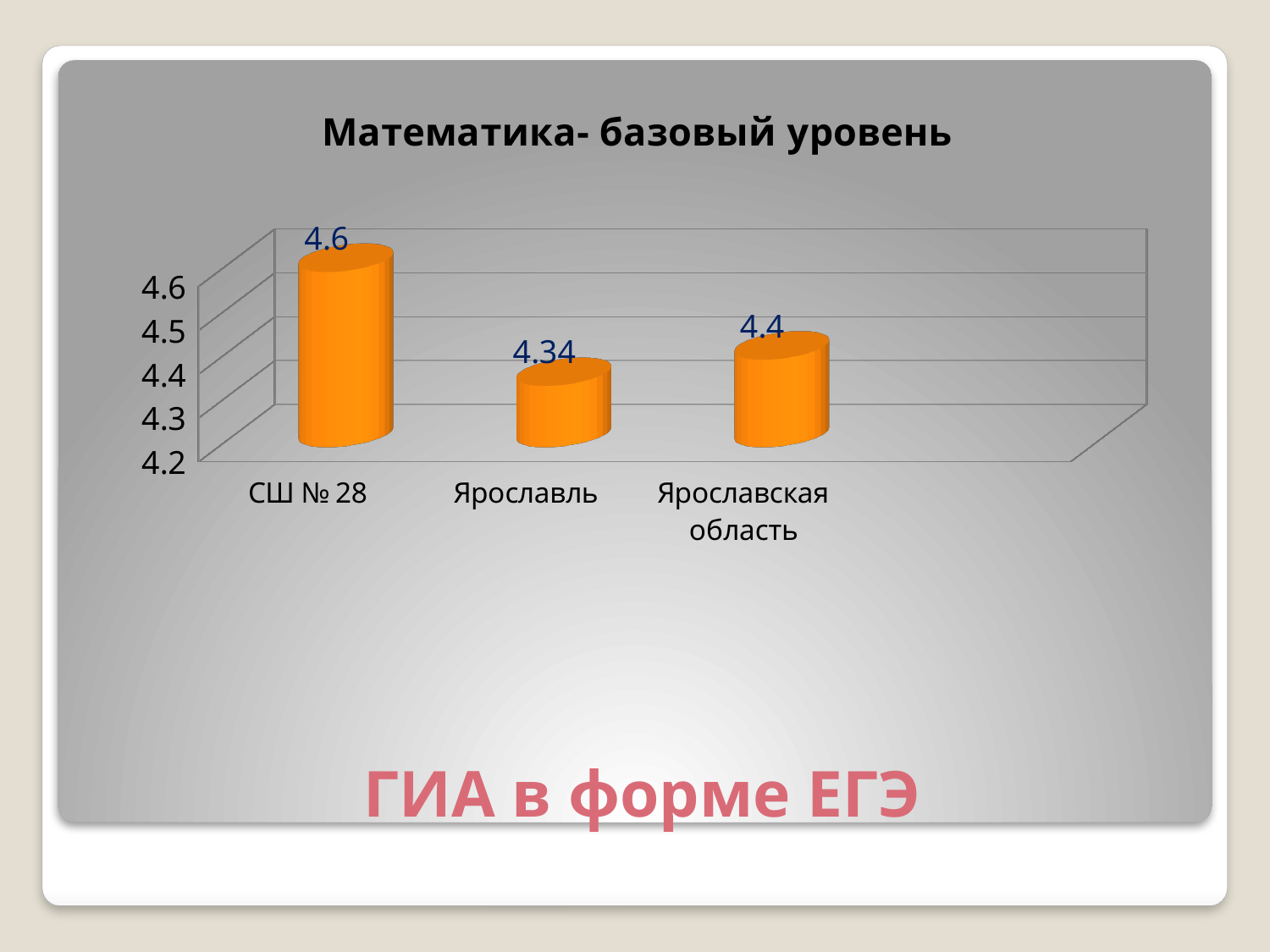
Which is larger, the value for СШ № 28 or the value for Ярославская область? СШ № 28 How many categories are shown in the chart? 3 Is the value for Ярославль greater or less than 4.5? less What kind of chart is shown on the slide? bar chart Which category has the highest value? СШ № 28 What is the value for Ярославская область? 4.4 Which category has the lowest value? Ярославль What is the value for СШ № 28? 4.6 What is the difference between the values for Ярославская область and Ярославль? 0.06 What is the title of the chart? Математика- базовый уровень What is the value for Ярославль? 4.34 What is the difference between the values for СШ № 28 and Ярославль? 0.26